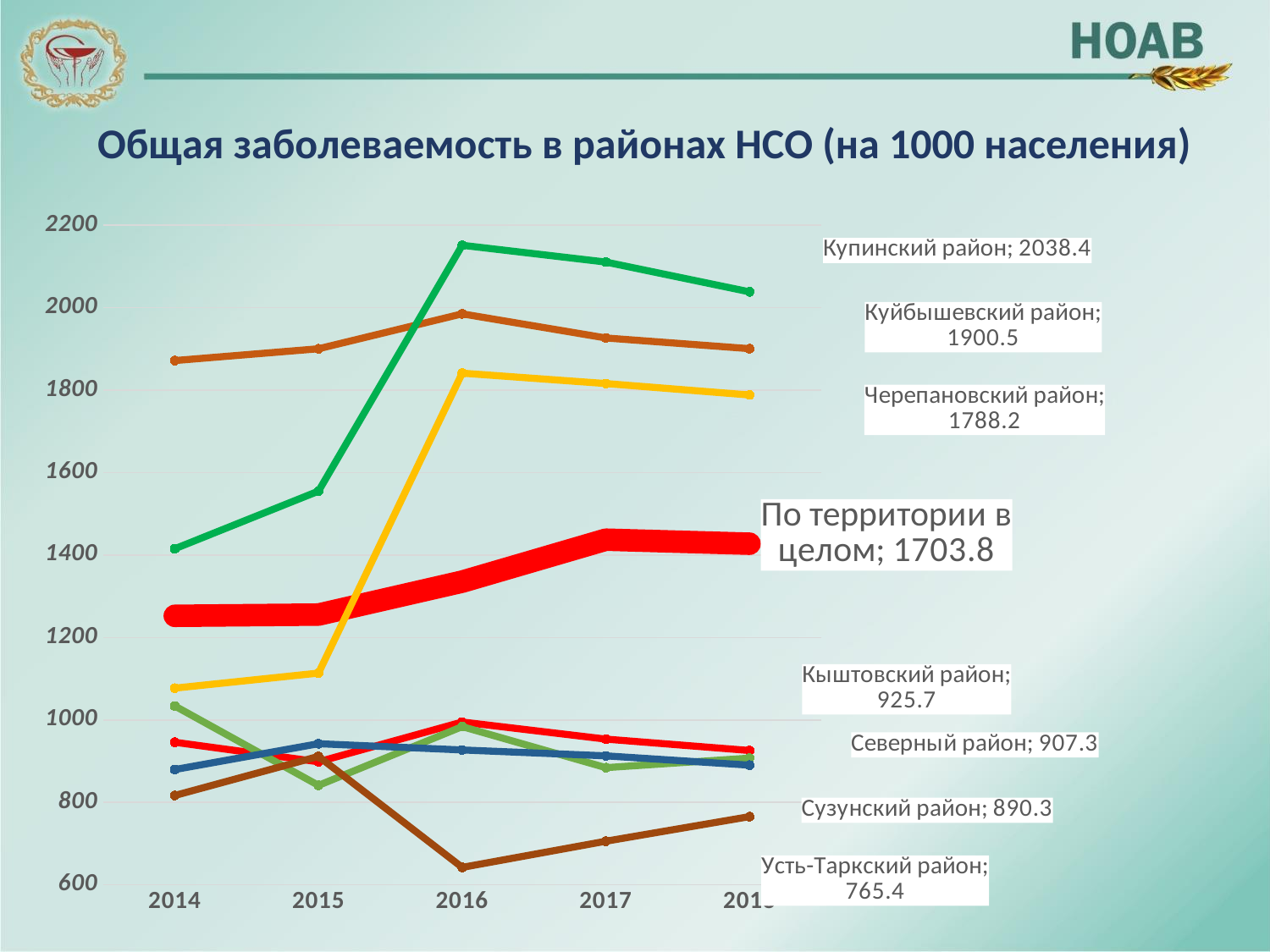
Which is larger in 2018: Сузунский район or Северный район? Северный район Is the value for Купинский район in 2016 greater or less than 2000? greater What is the value for Черепановский район in 2018? 1788.2 Which district has the highest value in 2018? Купинский район Which district has the lowest value in 2018? Усть-Тарский район What is the difference between the 2018 values for Купинский район and Куйбышевский район? 137.9 How many years are shown on the x axis? 5 What is the value for Купинский район in 2018? 2038.4 What kind of chart is shown on the slide? line chart What is the value for Усть-Тарский район in 2018? 765.4 What is the value for Куйбышевский район in 2018? 1900.5 What is the difference between the 2018 values for Кыштовский район and Северный район? 18.4